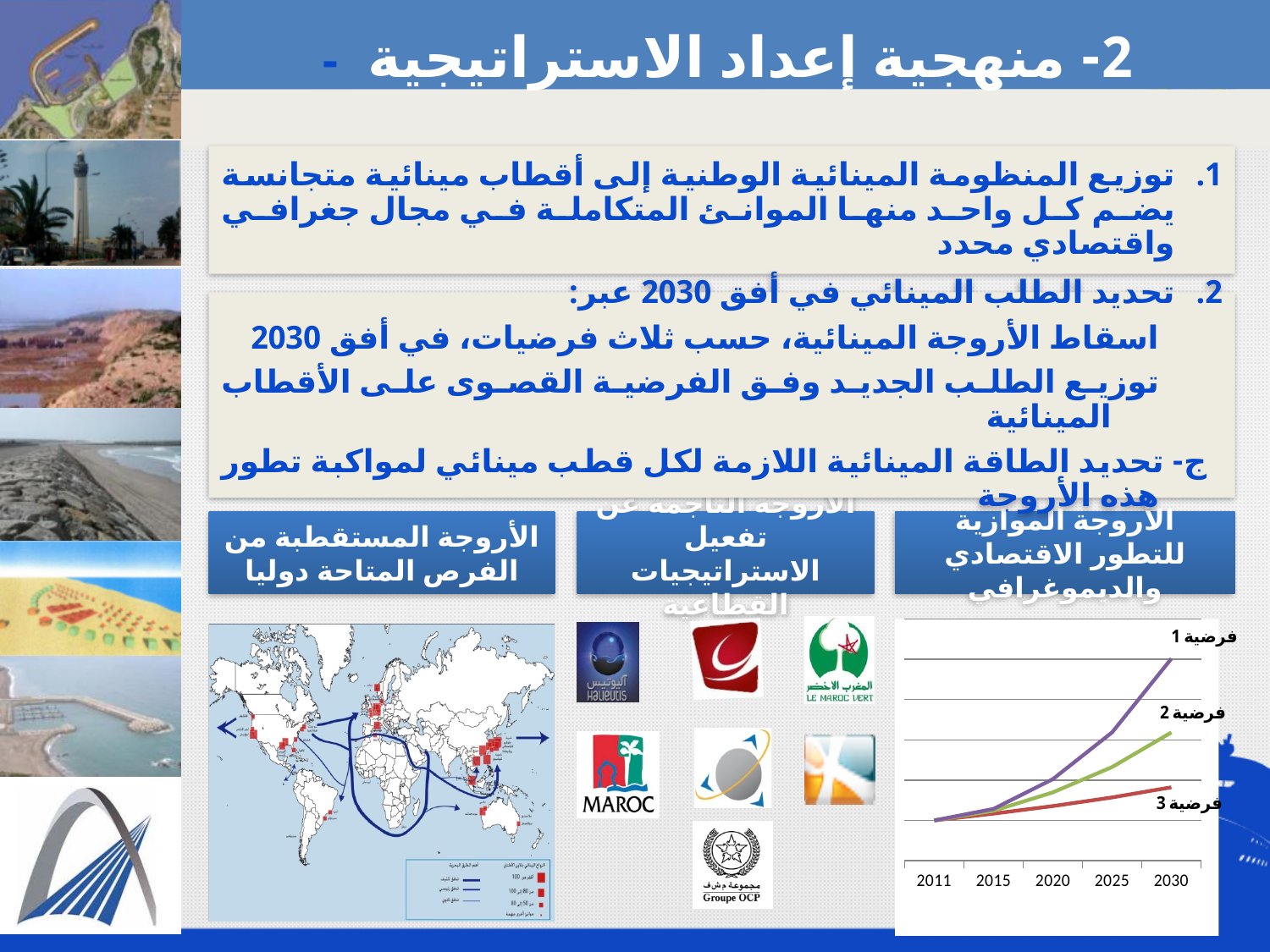
How many lines (series) are plotted in the line chart at the bottom right? 3 In the line chart at the bottom right, which series is highest in 2030? فرضية 1 What kind of chart is shown at the bottom right of the slide? line chart In the line chart at the bottom right, which series is lowest in 2030? فرضية 3 In the line chart at the bottom right, do the values of فرضية 3 rise or fall from 2011 to 2030? rise How many year labels are shown on the x axis of the line chart at the bottom right? 5 In the line chart at the bottom right, which is larger in 2030: فرضية 2 or فرضية 3? فرضية 2 What is the last year shown on the x axis of the line chart at the bottom right? 2030 In the line chart at the bottom right, do the values of فرضية 1 rise or fall from 2011 to 2030? rise What is the first year shown on the x axis of the line chart at the bottom right? 2011